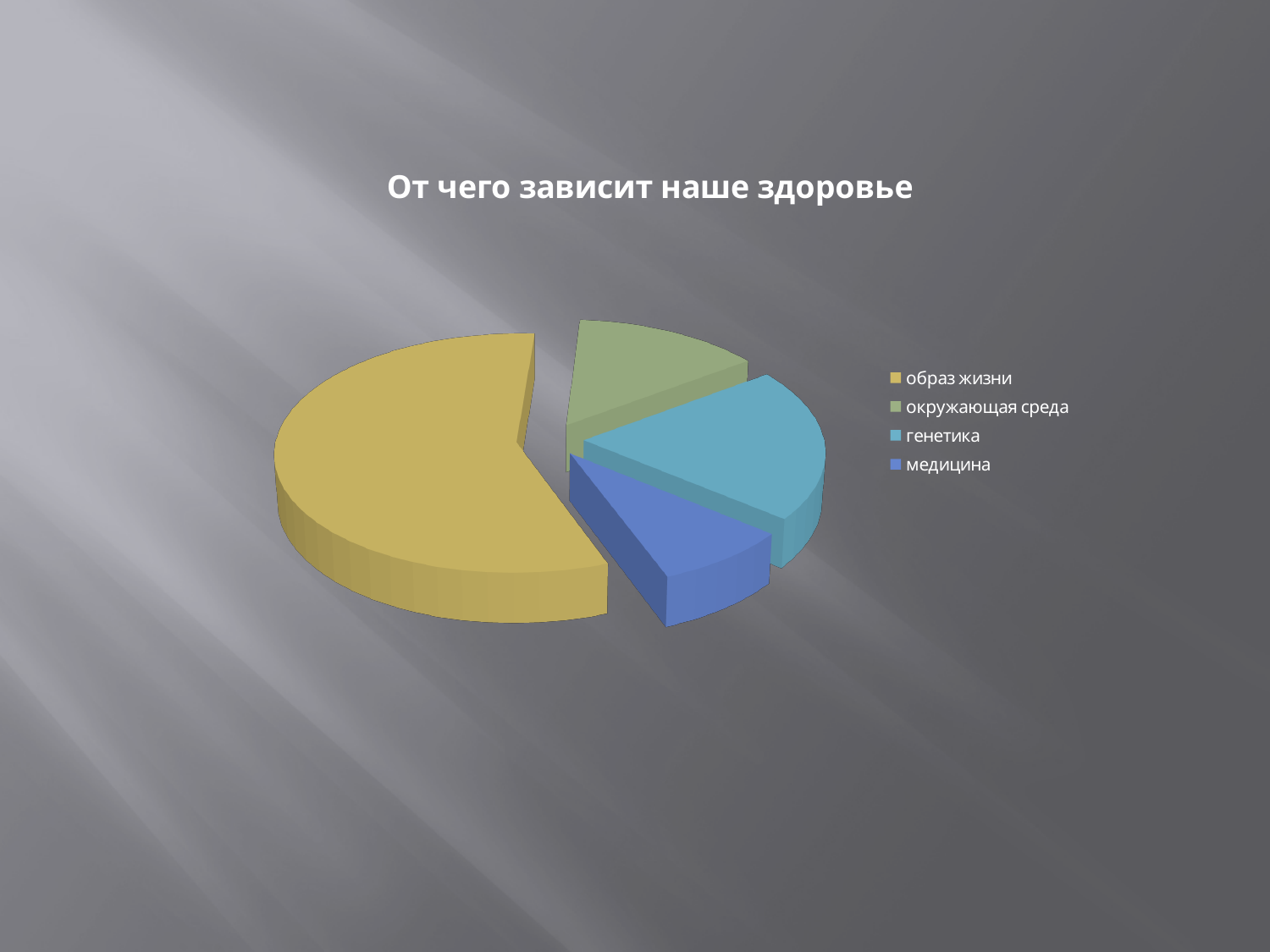
How many entries does the legend list? 4 Which slice is larger, окружающая среда or медицина? окружающая среда Which slice is larger, образ жизни or медицина? образ жизни Which category has the smallest slice of the pie? медицина What colour is the slice for образ жизни? yellow What is the title of the chart? От чего зависит наше здоровье Which slice is larger, образ жизни or генетика? образ жизни Which category has the largest slice of the pie? образ жизни How many slices does the pie chart have? 4 What kind of chart is shown on the slide? pie chart